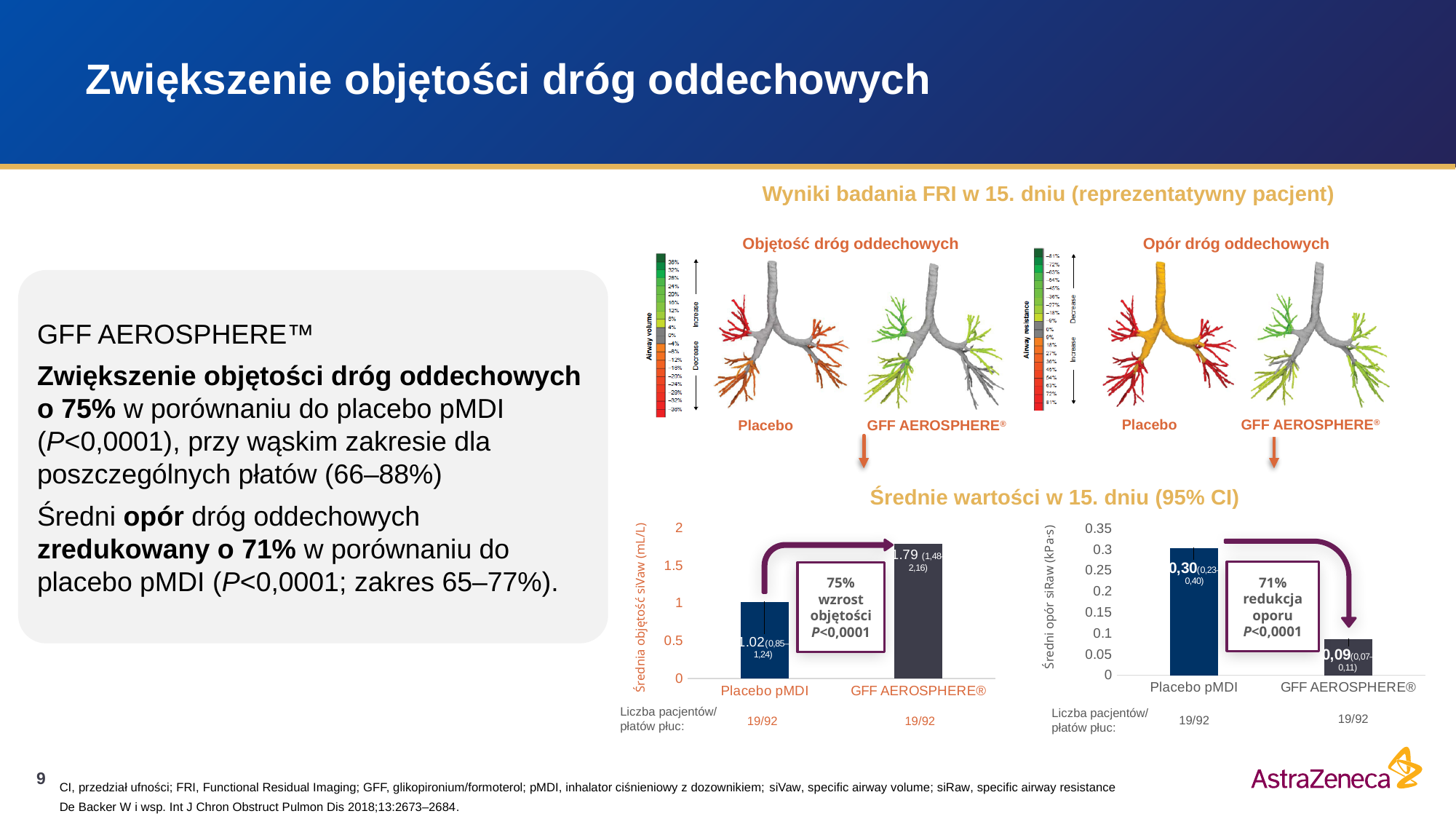
In the right chart (Średni opór siRaw), what is the value for GFF AEROSPHERE®? 0,09 In the right chart (Średni opór siRaw), which category has the lowest value? GFF AEROSPHERE® In the left chart (Średnia objętość siVaw), is the value for Placebo pMDI greater or less than 1.5? less In the left chart (Średnia objętość siVaw), what is the value for Placebo pMDI? 1.02 What kind of chart is the right chart (Średni opór siRaw)? bar chart In the right chart (Średni opór siRaw), what is the difference between the Placebo pMDI and GFF AEROSPHERE® values? 0,21 How many categories are shown in the left chart (Średnia objętość siVaw)? 2 In the left chart (Średnia objętość siVaw), what is the difference between the GFF AEROSPHERE® and Placebo pMDI values? 0.77 In the right chart (Średni opór siRaw), what is the value for Placebo pMDI? 0,30 In the left chart (Średnia objętość siVaw), what is the value for GFF AEROSPHERE®? 1.79 In the left chart (Średnia objętość siVaw), which category has the higher value? GFF AEROSPHERE® In the right chart (Średni opór siRaw), is the value for Placebo pMDI greater or less than 0.25? greater